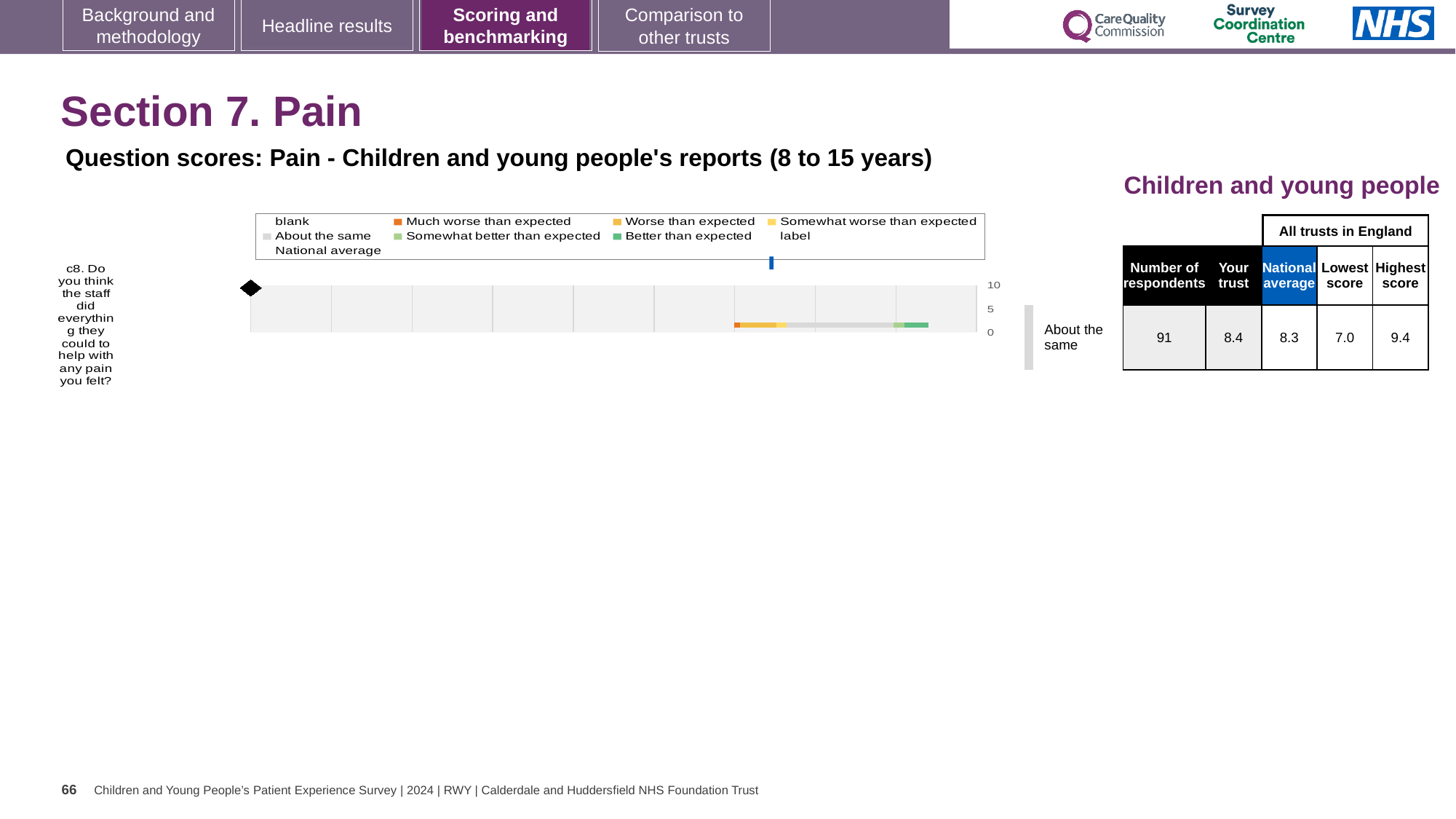
What kind of chart is shown on the slide? bar chart How many respondents answered question c8? 91 What is the national average score for question c8? 8.3 What benchmark category label is shown for question c8? About the same Which is larger for question c8, the 'Your trust' score or the national average? Your trust Which survey question is plotted in the chart? c8. Do you think the staff did everything they could to help with any pain you felt? What is the difference between the highest score and the lowest score for question c8? 2.4 What is the lowest score among all trusts in England for question c8? 7.0 How many survey questions are plotted in the chart? 1 What is the 'Your trust' score for question c8? 8.4 What is the highest score among all trusts in England for question c8? 9.4 What is the difference between the 'Your trust' score and the national average for question c8? 0.1